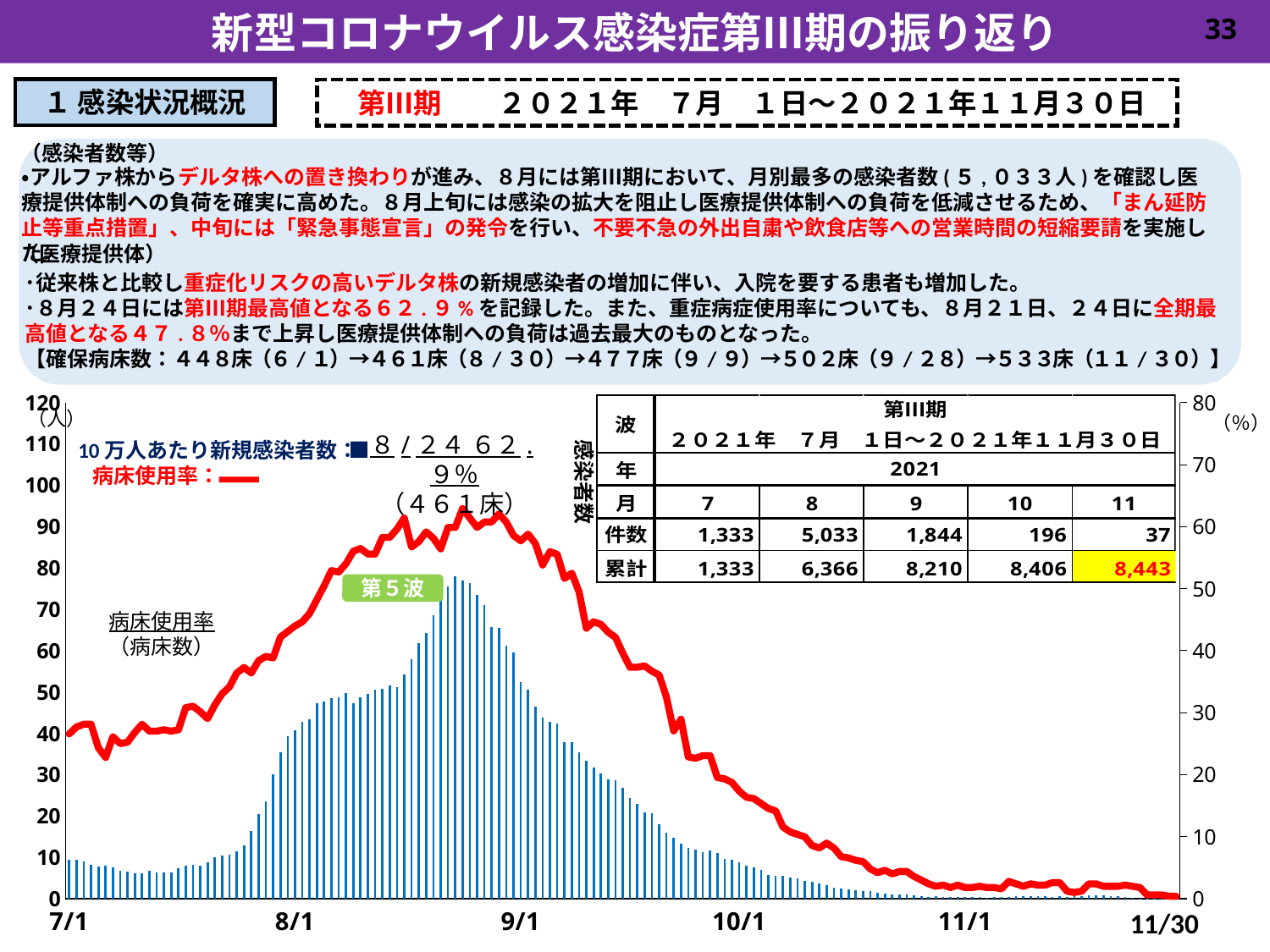
Is the highest bar for new infections per 100,000 people greater or less than 70? greater Is the bed usage rate (red line) at 7/1 greater or less than 30%? less What colour is the line representing 病床使用率 in the chart? Red How many series does the chart legend list? 2 Are the bars for new infections per 100,000 people around 11/1 greater or less than 10? less How many beds (床) are noted in the annotation at the peak of the bed usage rate line? 461床 What kind of chart is shown at the bottom of the slide? A combination bar and line chart In the table on the chart, which month has the highest number of cases (件数)? 8 (5,033) How does the bed usage rate line change from 7/1 to 11/30? It rises to a peak in late August, then falls Which wave label is shown on the chart near the peak? 第5波 What is the peak bed usage rate (病床使用率) annotated on the chart, and on what date? 62.9% on 8/24